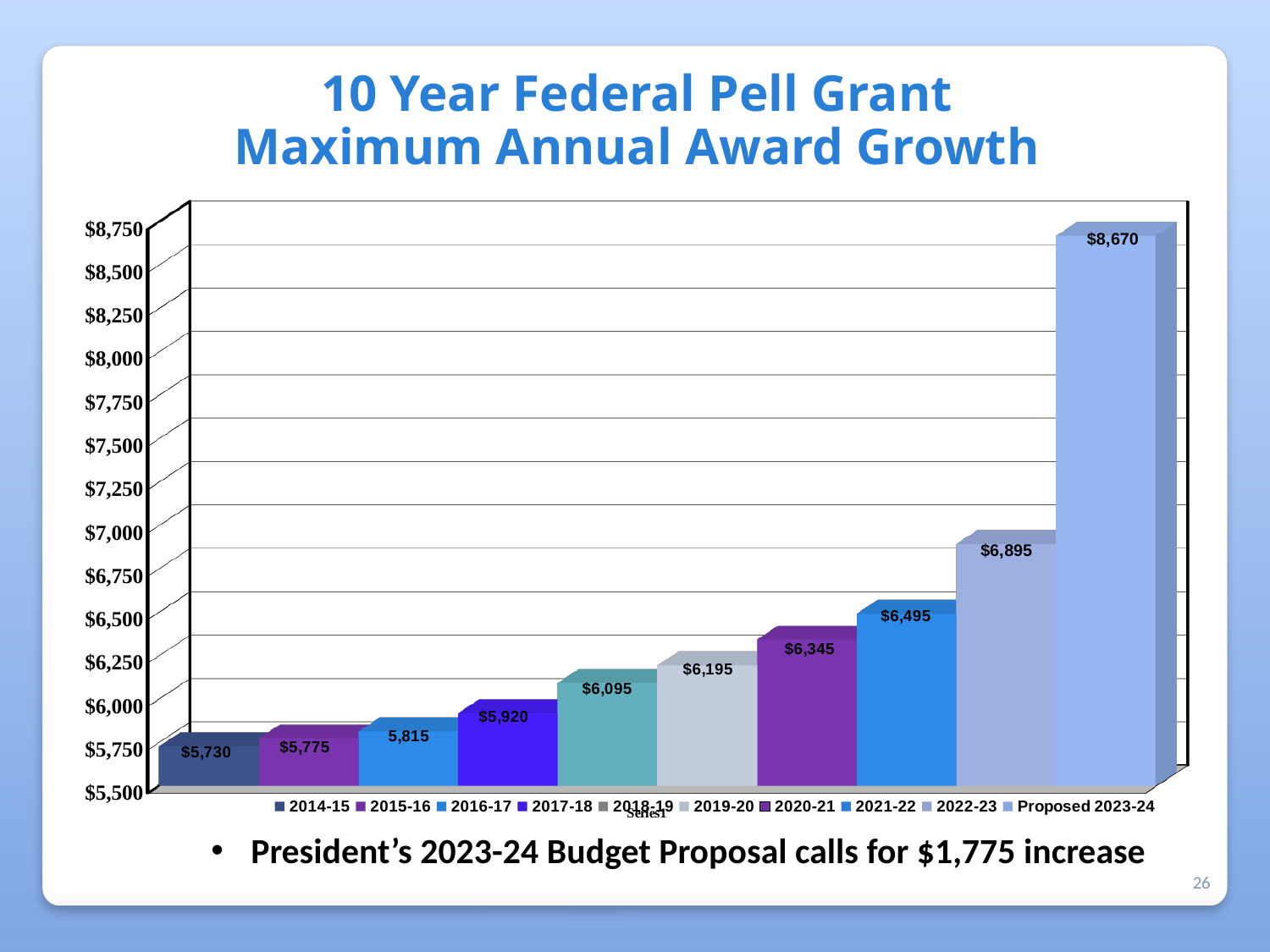
Which is larger, the value for 2019-20 or the value for 2018-19? 2019-20 What value is shown for 2016-17? 5,815 What is the value shown for Proposed 2023-24? $8,670 How many entries does the legend list? 10 Which year has the lowest maximum award on the chart? 2014-15 Which year has the highest maximum award on the chart? Proposed 2023-24 What is the value shown for 2022-23? $6,895 Do the values rise or fall from 2014-15 to Proposed 2023-24? rise What is the maximum Pell Grant award shown for 2014-15? $5,730 What is the difference between the 2021-22 value and the 2020-21 value? $150 What is the difference between the Proposed 2023-24 value and the 2022-23 value? $1,775 How many bars are plotted on the chart? 10